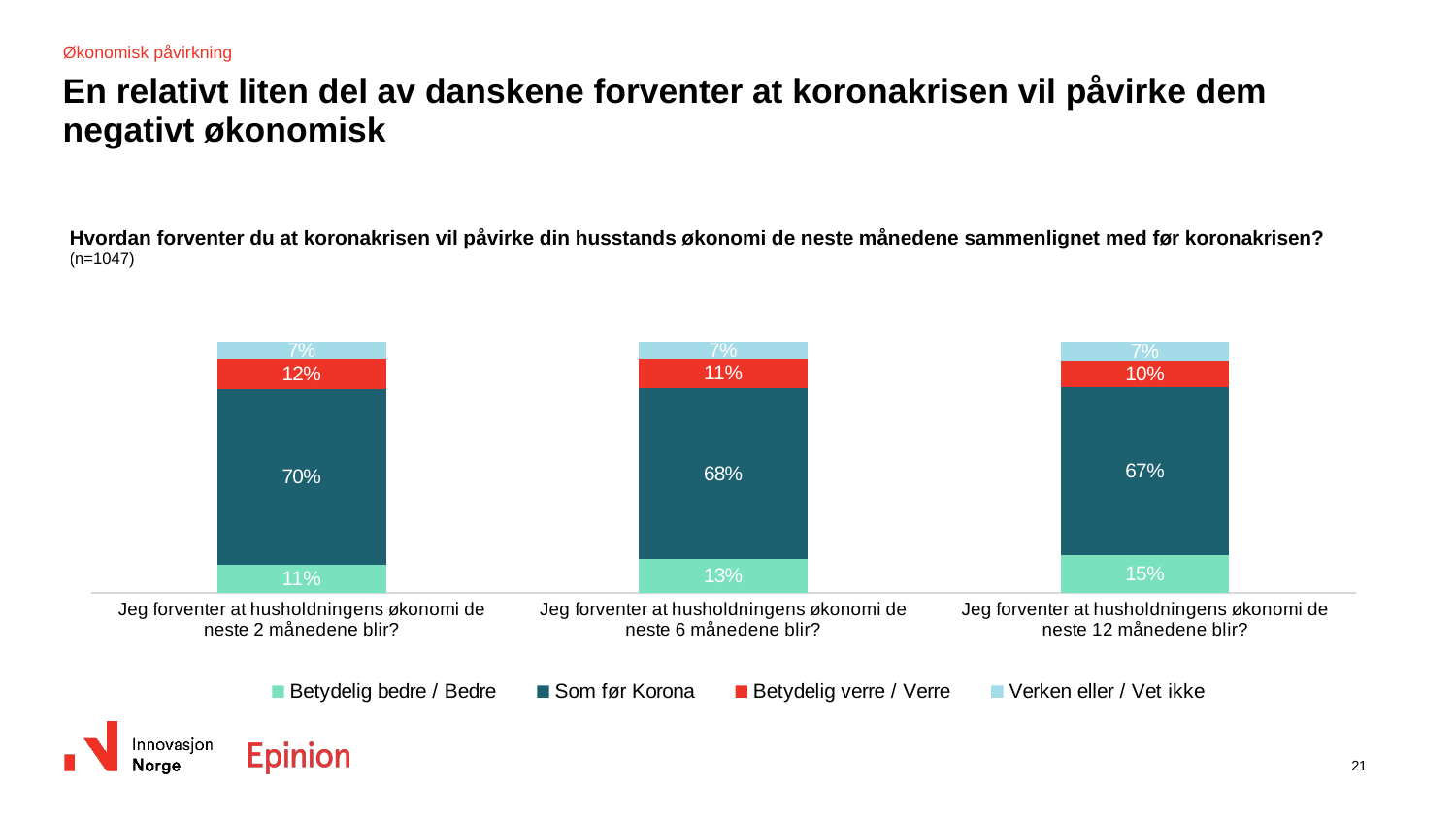
What kind of chart is shown on the slide? Stacked bar chart How many categories are shown on the x axis? 3 What is the value for 'Som før Korona' in the 'neste 2 månedene' category? 70% Which category has the lowest value for 'Betydelig bedre / Bedre'? Jeg forventer at husholdningens økonomi de neste 2 månedene blir? What is the value for 'Verken eller / Vet ikke' in the 'neste 12 månedene' category? 7% Which category has the highest value for 'Som før Korona'? Jeg forventer at husholdningens økonomi de neste 2 månedene blir? What is the difference between the 'Som før Korona' values for the 'neste 2 månedene' and 'neste 12 månedene' categories? 3 percentage points How many series does the legend list? 4 Do the 'Som før Korona' values rise or fall from the 2-month to the 12-month category? Fall Which is larger: 'Betydelig verre / Verre' for 'neste 2 månedene' or for 'neste 12 månedene'? neste 2 månedene What is the value for 'Betydelig verre / Verre' in the 'neste 6 månedene' category? 11% What is the value for 'Betydelig bedre / Bedre' in the 'neste 12 månedene' category? 15%